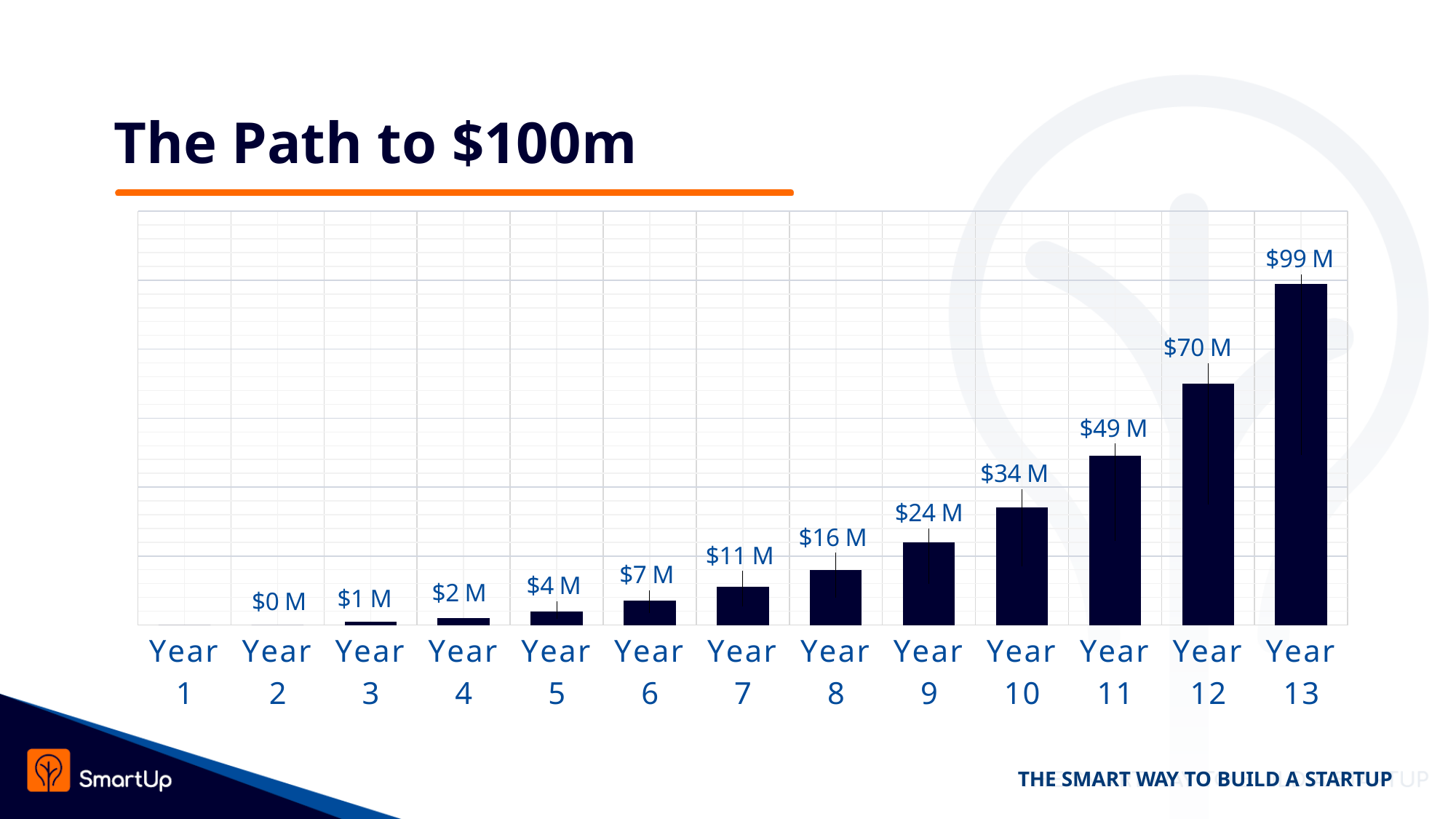
What is the difference between the values for Year 13 and Year 12? $29 M What is the value for Year 10? $34 M What is the title of the slide? The Path to $100m Do the values rise or fall from Year 2 to Year 13? Rise What is the value for Year 8? $16 M What is the difference between the values for Year 11 and Year 9? $25 M Which is larger, the value for Year 7 or the value for Year 9? Year 9 How many years are shown on the x axis? 13 What is the value for Year 13? $99 M Which year has the highest value? Year 13 What is the value for Year 5? $4 M What kind of chart is shown on the slide? Bar chart